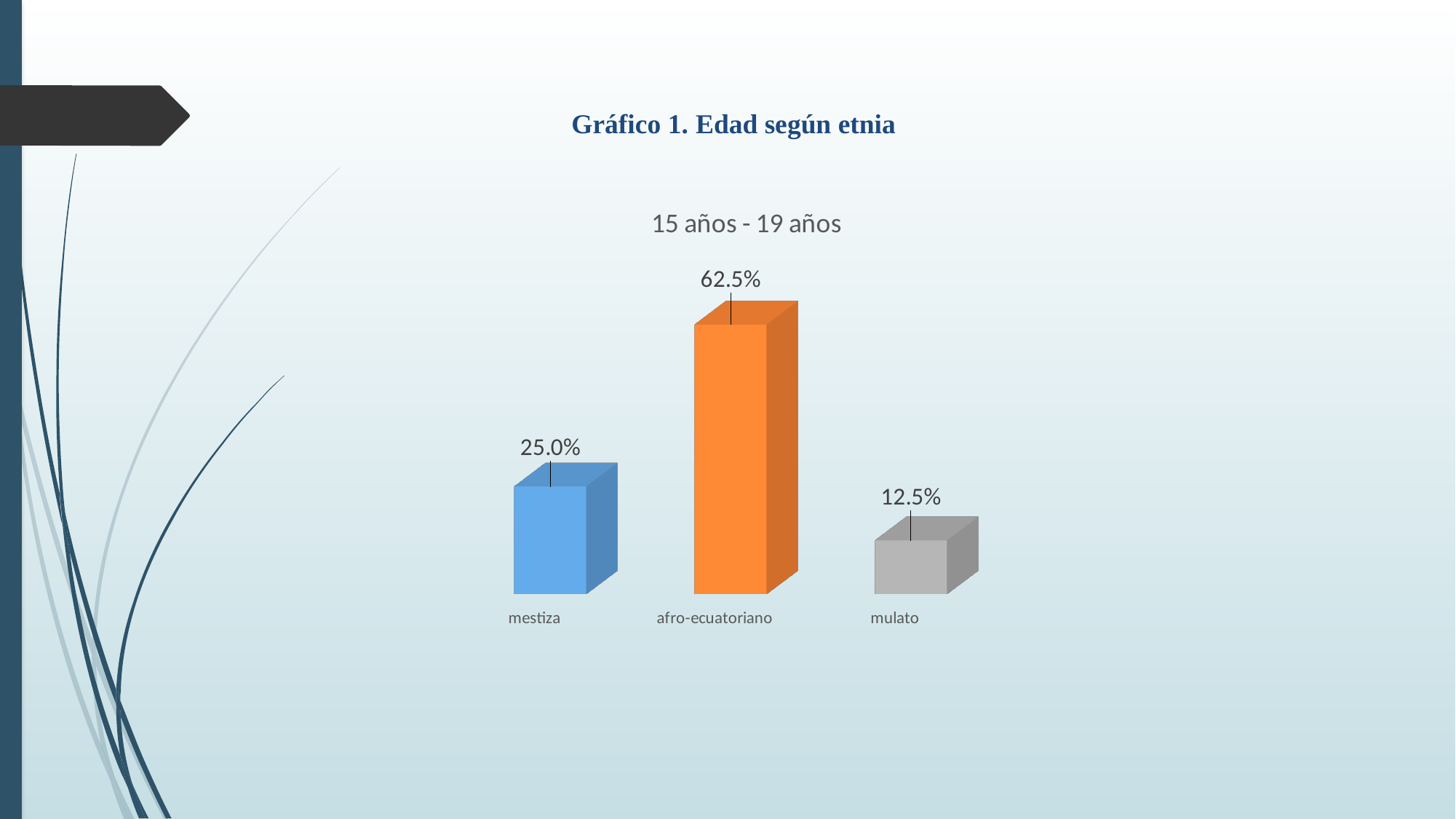
What is the difference between the values for afro-ecuatoriano and mestiza? 37.5% How many categories are shown in the chart? 3 Which category has the highest value? afro-ecuatoriano What kind of chart is shown on the slide? bar chart What is the value for mestiza? 25.0% What is the title of the chart? 15 años - 19 años What colour is the bar for afro-ecuatoriano? orange What is the value for afro-ecuatoriano? 62.5% What is the value for mulato? 12.5% Which is larger, the value for mestiza or the value for mulato? mestiza What is the difference between the values for mestiza and mulato? 12.5% Which category has the lowest value? mulato